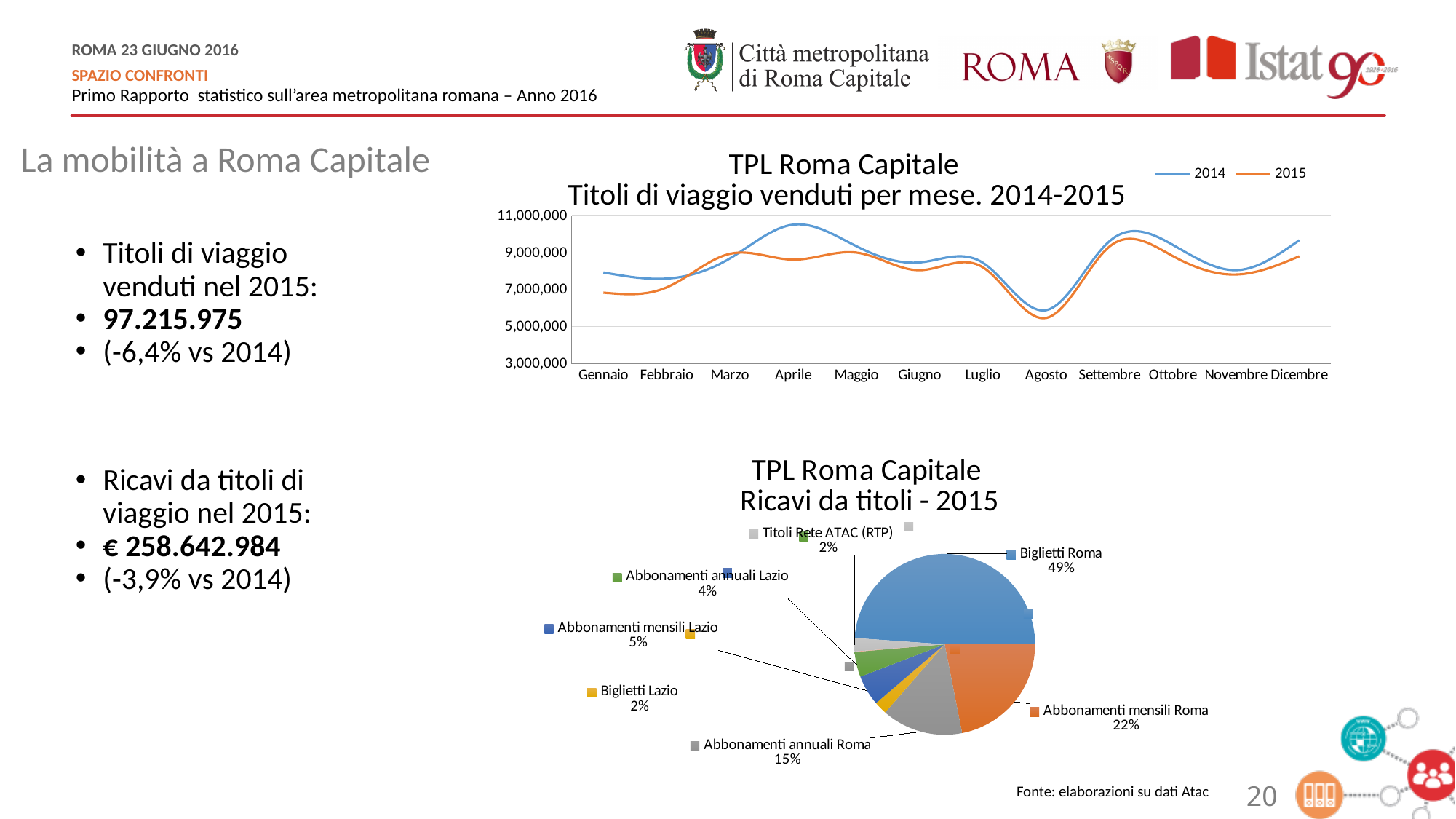
What kind of chart is the top chart titled 'TPL Roma Capitale Titoli di viaggio venduti per mese. 2014-2015'? line chart In the top line chart, how many series does the legend list? 2 In the bottom pie chart, which category has the largest share? Biglietti Roma In the top line chart, how many months are shown on the x axis? 12 In the top line chart, which month has the lowest value for the 2015 series? Agosto In the top line chart, which series has the larger value in Aprile, 2014 or 2015? 2014 In the bottom pie chart, what is the difference in percentage points between Biglietti Roma and Abbonamenti mensili Roma? 27 In the bottom pie chart, what share is labelled for Abbonamenti annuali Roma? 15% In the top line chart, is the 2015 value for Agosto greater or less than 7,000,000? less In the bottom pie chart, what share is labelled for Biglietti Roma? 49% What kind of chart is the bottom chart titled 'TPL Roma Capitale Ricavi da titoli - 2015'? pie chart In the top line chart, is the 2014 value for Aprile greater or less than 9,000,000? greater